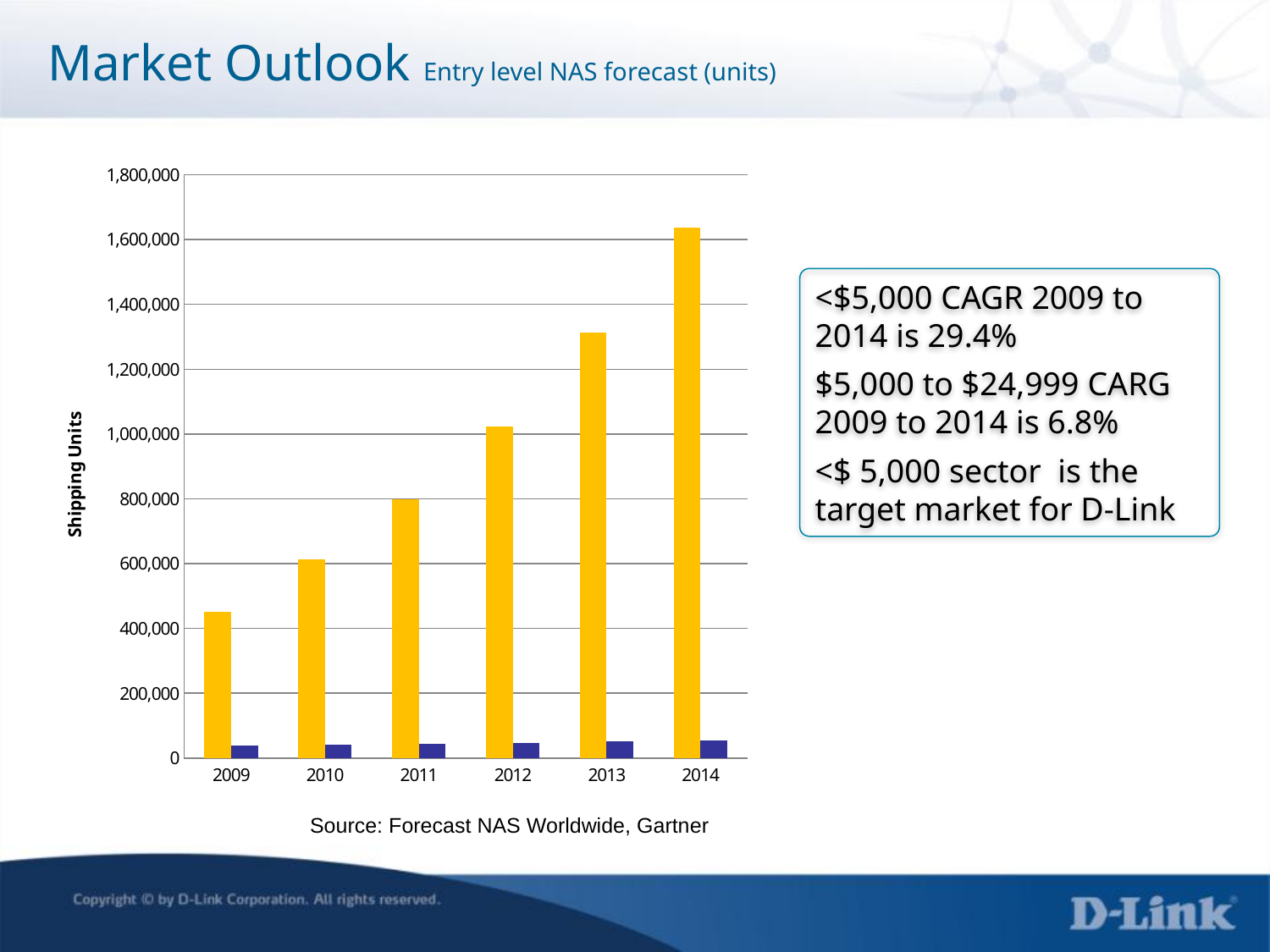
Do the yellow bars rise or fall from 2009 to 2014? rise Is the yellow bar for 2013 greater or less than 1,200,000? greater What kind of chart is shown on the slide? bar chart In which year is the yellow bar lowest? 2009 In which year is the yellow bar highest? 2014 Is the yellow bar for 2009 greater or less than 600,000? less What is the label of the vertical axis of the chart? Shipping Units Is the blue bar for 2014 greater or less than 200,000? less How many years are shown on the x axis of the chart? 6 In 2012, which bar is larger, the yellow bar or the blue bar? the yellow bar What source is cited below the chart? Forecast NAS Worldwide, Gartner